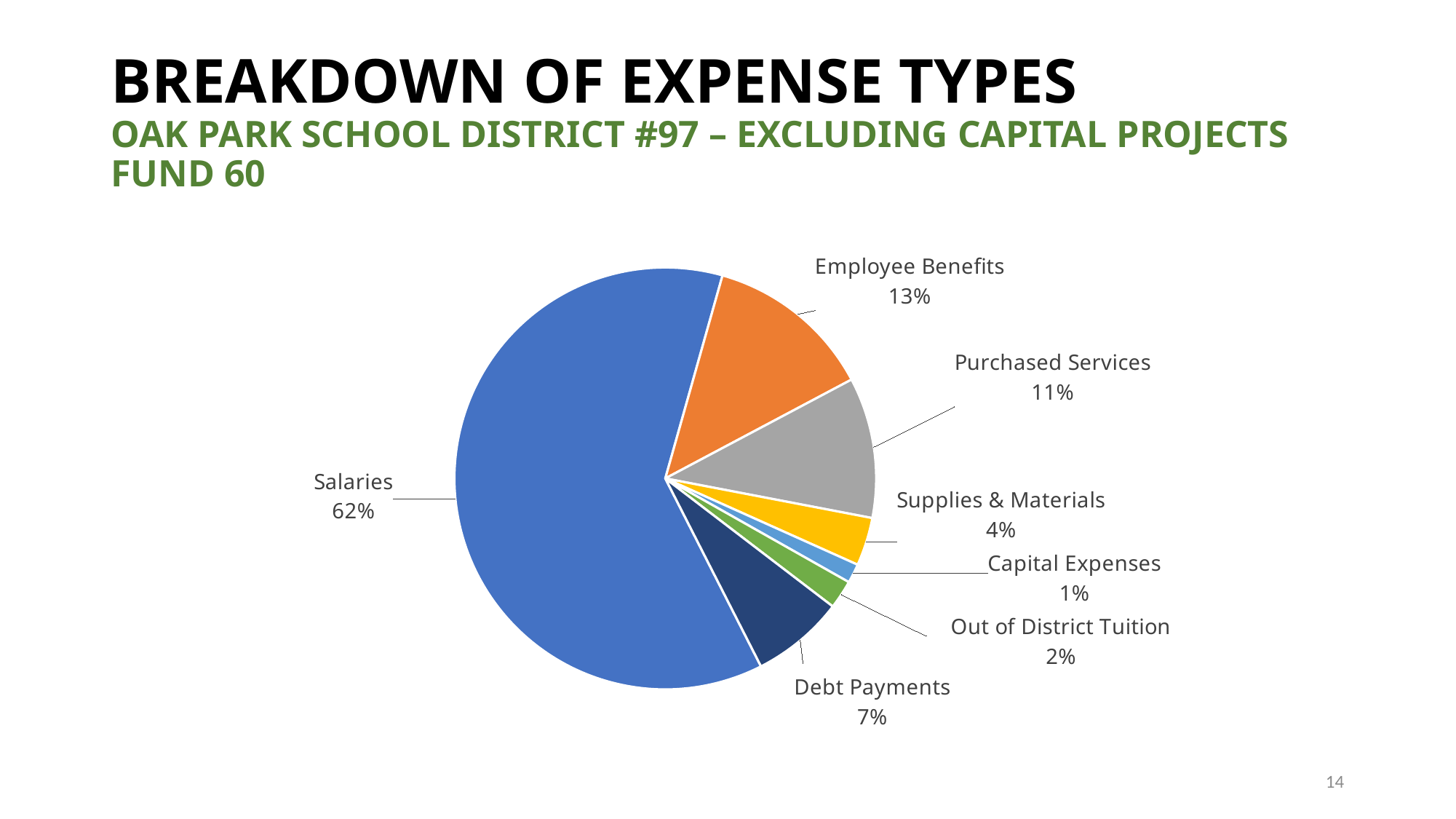
What type of chart is shown on the slide? Pie chart Which expense type has the largest share of the pie? Salaries How many expense types are shown in the pie chart? 7 What share of expenses is Purchased Services? 11% What share of expenses is Capital Expenses? 1% What share of expenses is Salaries? 62% Which expense type has the smallest share of the pie? Capital Expenses What colour is the Salaries slice? Blue What percentage of expenses is Employee Benefits? 13% What is the difference in percentage points between Employee Benefits and Purchased Services? 2 What percentage is shown for Debt Payments? 7% Which is larger, Supplies & Materials or Out of District Tuition? Supplies & Materials